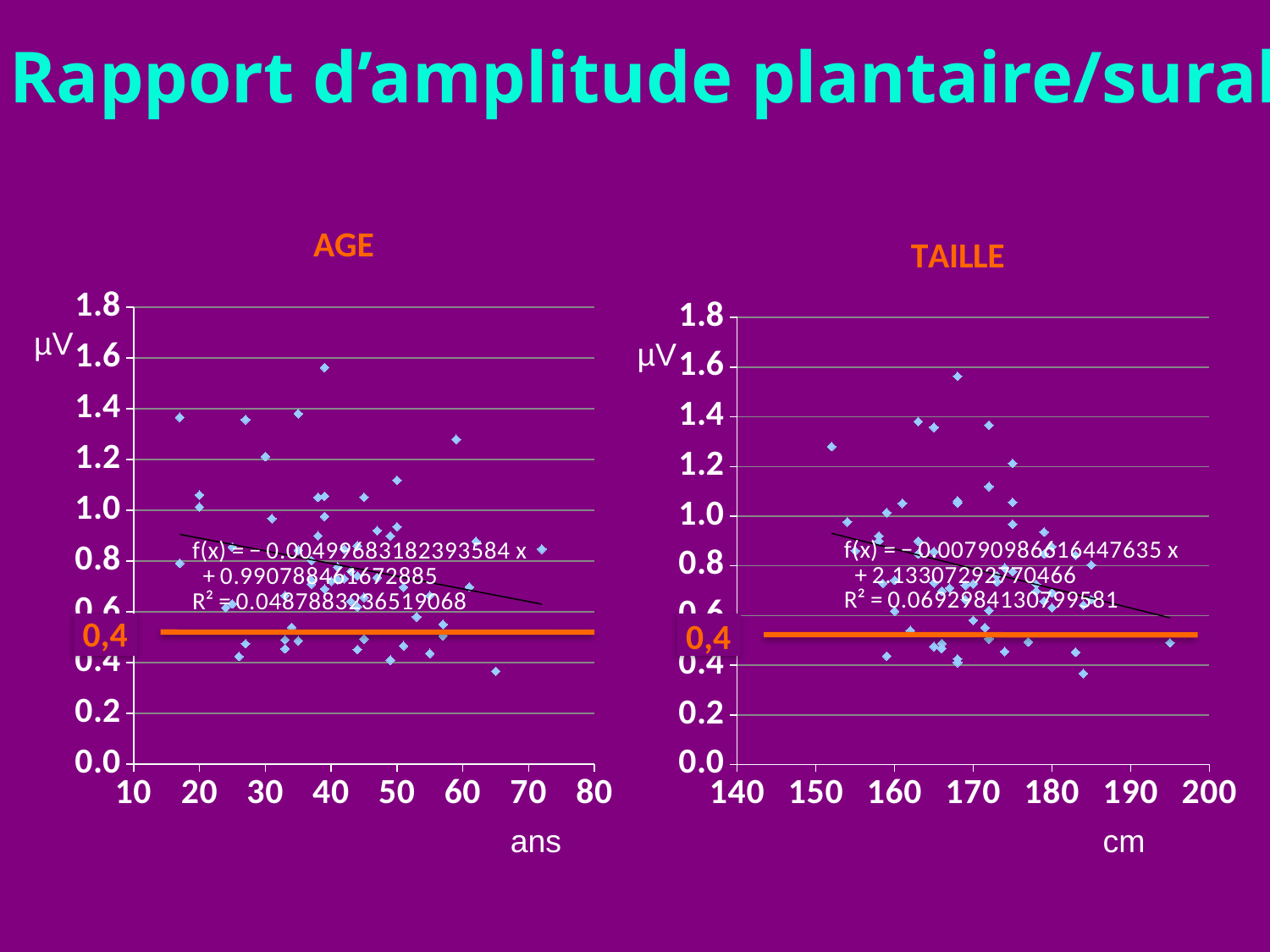
What is the x-axis unit label of the TAILLE chart? cm What kind of chart is the TAILLE chart? scatter chart In the TAILLE chart, does the trendline rise or fall as height increases? fall In the AGE chart, what is the R² value shown for the trendline? 0.0487883236519068 In the AGE chart, is the highest plotted point greater or less than 1.4? greater In the AGE chart, what is the trendline equation shown? f(x) = − 0.00499683182393584 x + 0.990788461672885 In the TAILLE chart, what is the trendline equation shown? f(x) = − 0.00790986616447635 x + 2.13307292770466 In the TAILLE chart, is the lowest plotted point greater or less than 0.4? less What kind of chart is the AGE chart? scatter chart What value is labelled on the orange horizontal line in both charts? 0,4 In the AGE chart, does the trendline rise or fall as age increases? fall In the TAILLE chart, what is the R² value shown for the trendline? 0.0692984130799581